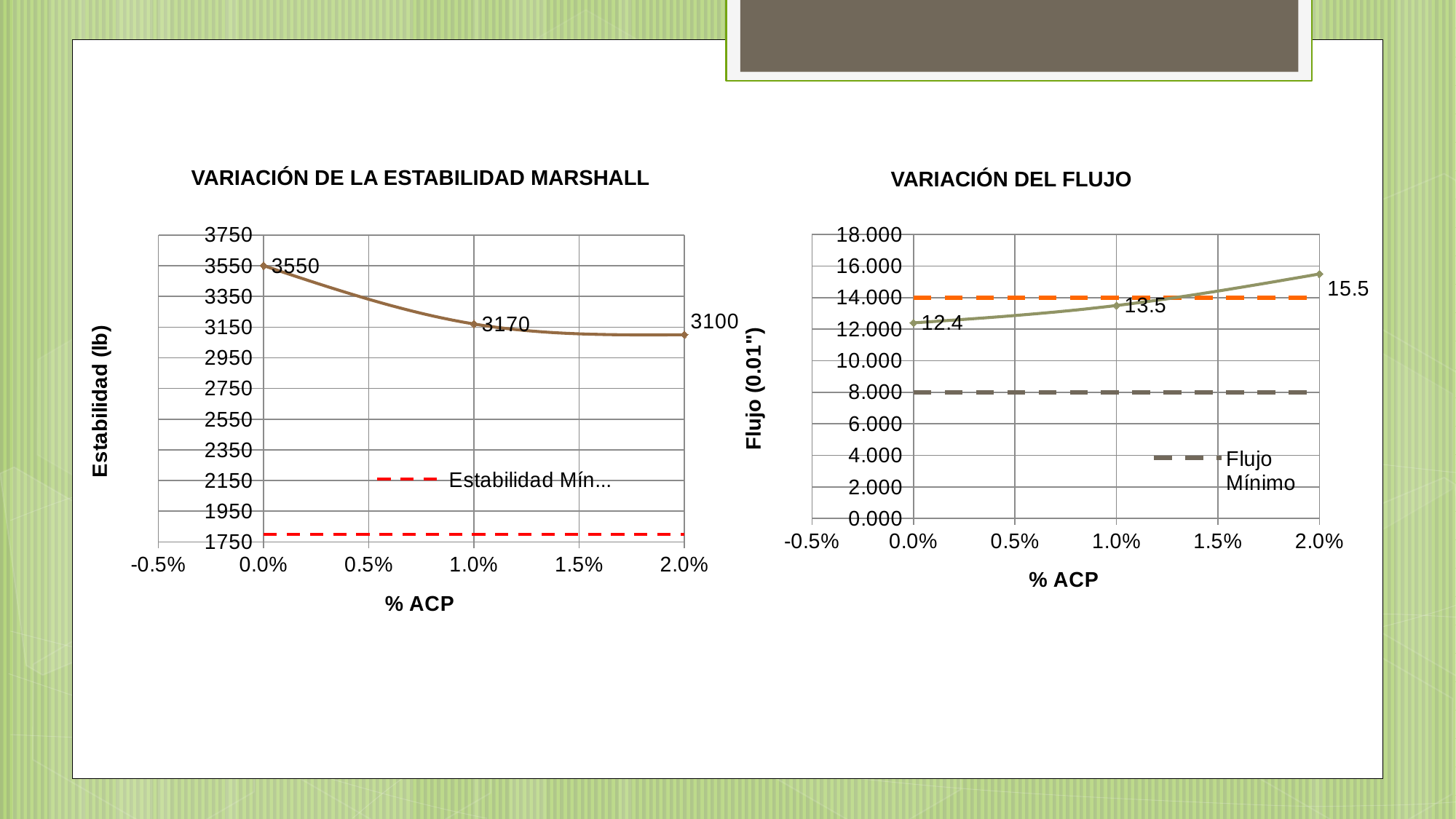
In the chart titled VARIACIÓN DEL FLUJO, is the flow at 2.0% ACP greater or less than 14.000? greater In the chart titled VARIACIÓN DE LA ESTABILIDAD MARSHALL, what is the stability value at 2.0% ACP? 3100 In the chart titled VARIACIÓN DEL FLUJO, what is the flow value at 2.0% ACP? 15.5 In the chart titled VARIACIÓN DEL FLUJO, how many data points are plotted on the flow line? 3 In the chart titled VARIACIÓN DE LA ESTABILIDAD MARSHALL, what is the stability value at 0.0% ACP? 3550 In the chart titled VARIACIÓN DE LA ESTABILIDAD MARSHALL, what is the difference between the stability at 0.0% ACP and at 2.0% ACP? 450 In the chart titled VARIACIÓN DE LA ESTABILIDAD MARSHALL, does the stability rise or fall as % ACP increases? fall In the chart titled VARIACIÓN DE LA ESTABILIDAD MARSHALL, what is the stability value at 1.0% ACP? 3170 In the chart titled VARIACIÓN DEL FLUJO, what is the difference between the flow at 1.0% ACP and at 0.0% ACP? 1.1 In the chart titled VARIACIÓN DEL FLUJO, what is the flow value at 0.0% ACP? 12.4 What kind of chart is the chart titled VARIACIÓN DEL FLUJO? line chart In the chart titled VARIACIÓN DEL FLUJO, at which % ACP is the flow highest? 2.0%